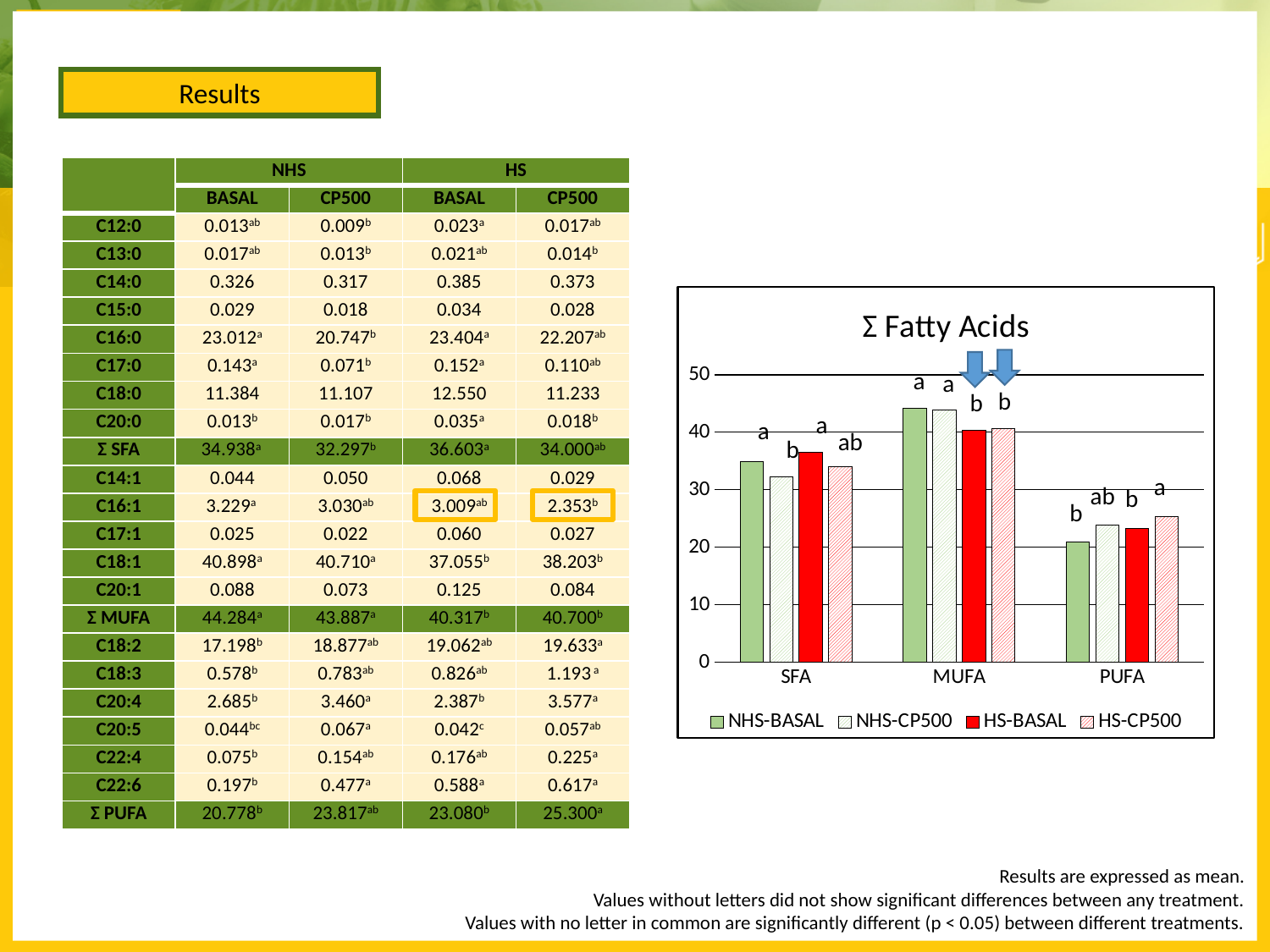
In the Σ Fatty Acids chart, is the NHS-BASAL value for MUFA greater or less than 40? greater How many categories are shown on the x axis of the Σ Fatty Acids chart? 3 How many series does the legend of the Σ Fatty Acids chart list? 4 In the Σ Fatty Acids chart, what colour are the HS-BASAL bars? red What is the title of the chart on the slide? Σ Fatty Acids In the Σ Fatty Acids chart, which category has the tallest bars overall? MUFA In the Σ Fatty Acids chart, which is larger for SFA: NHS-BASAL or NHS-CP500? NHS-BASAL In the Σ Fatty Acids chart, is the NHS-BASAL value for SFA greater or less than 30? greater In the Σ Fatty Acids chart, is the HS-CP500 value for PUFA greater or less than 30? less In the Σ Fatty Acids chart, which is larger for MUFA: NHS-BASAL or HS-BASAL? NHS-BASAL What kind of chart is shown on the slide? bar chart In the Σ Fatty Acids chart, which series has the lowest bar for PUFA? NHS-BASAL